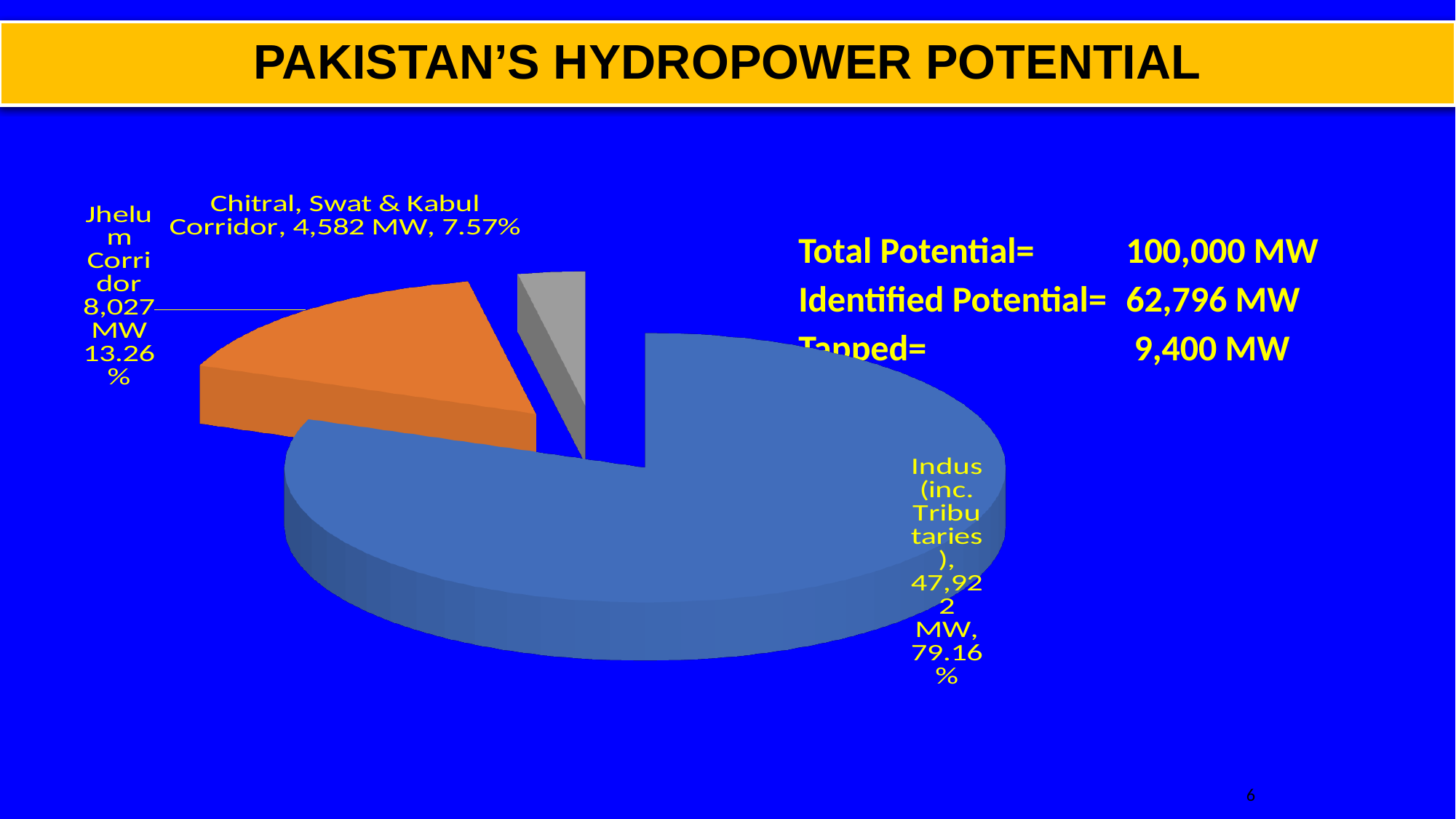
What is the value in MW for Indus (inc. Tributaries)? 47,922 MW Which is larger, the Jhelum Corridor or the Chitral, Swat & Kabul Corridor? Jhelum Corridor What share of the pie does the Chitral, Swat & Kabul Corridor represent? 7.57% How many slices does the pie chart have? 3 What is the value in MW for the Chitral, Swat & Kabul Corridor? 4,582 MW What share of the pie does the Jhelum Corridor represent? 13.26% What share of the pie does Indus (inc. Tributaries) represent? 79.16% What is the difference in MW between the Jhelum Corridor and the Chitral, Swat & Kabul Corridor? 3,445 MW Which slice of the pie chart is the smallest? Chitral, Swat & Kabul Corridor What type of chart is shown on the slide? Pie chart Which slice of the pie chart is the largest? Indus (inc. Tributaries) What is the value in MW for the Jhelum Corridor? 8,027 MW